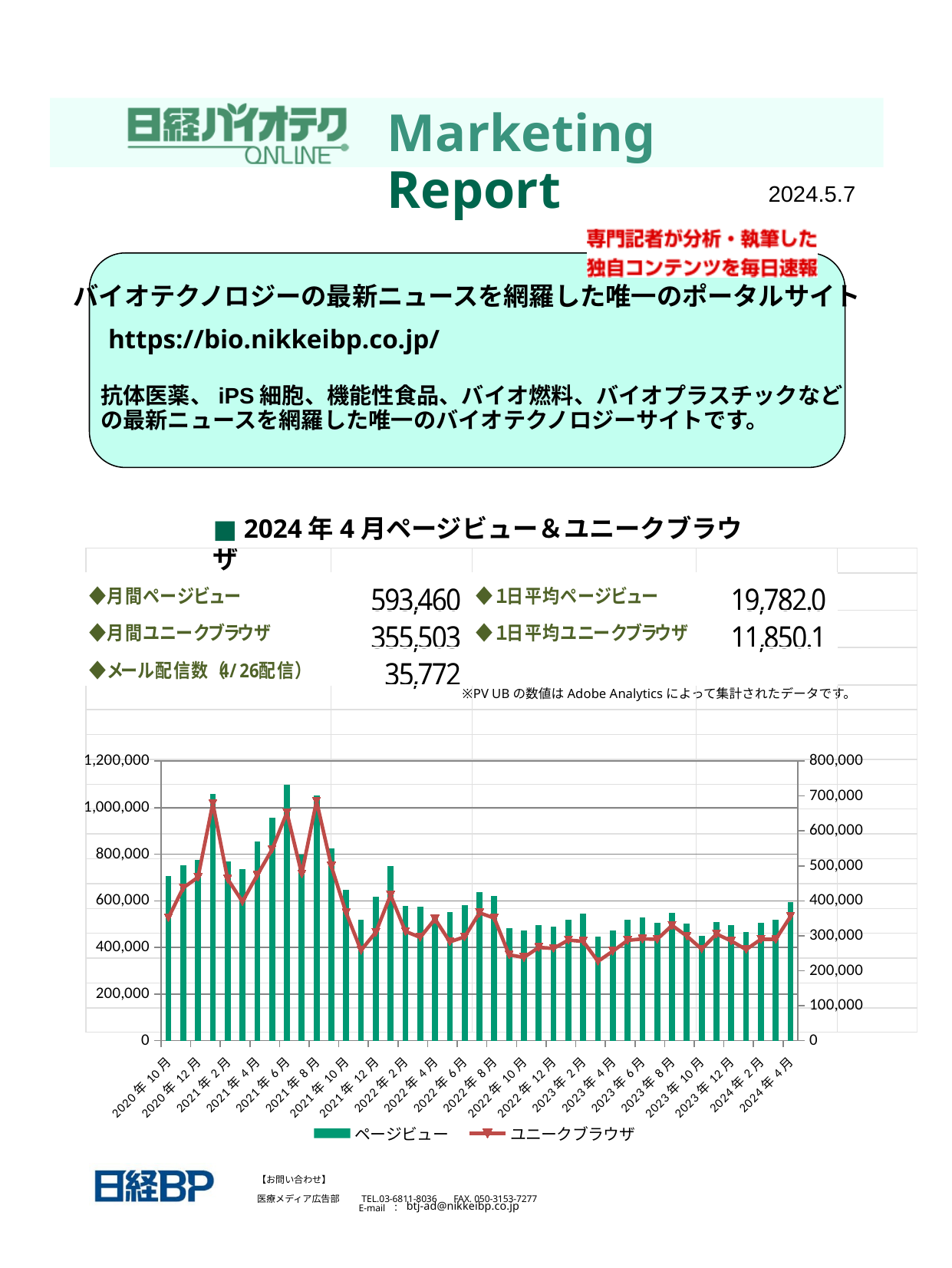
What is the first month label on the x axis of the chart? 2020年10月 How many series does the chart legend list? 2 Is the ページビュー value for 2021年6月 greater or less than 1,000,000? greater Is the ユニークブラウザ value for 2021年2月 greater or less than 600,000 on the right axis? less Is the ページビュー value for 2020年10月 greater or less than 800,000? less Do the ページビュー bars rise or fall from 2021年8月 to 2021年12月? fall Which series is drawn as bars in the chart? ページビュー What kind of chart is shown on the slide? A bar chart combined with a line chart Which has the higher ページビュー value, 2021年6月 or 2023年6月? 2021年6月 Which series is drawn as a line with markers in the chart? ユニークブラウザ In which month do the ページビュー bars reach their highest value? 2021年6月